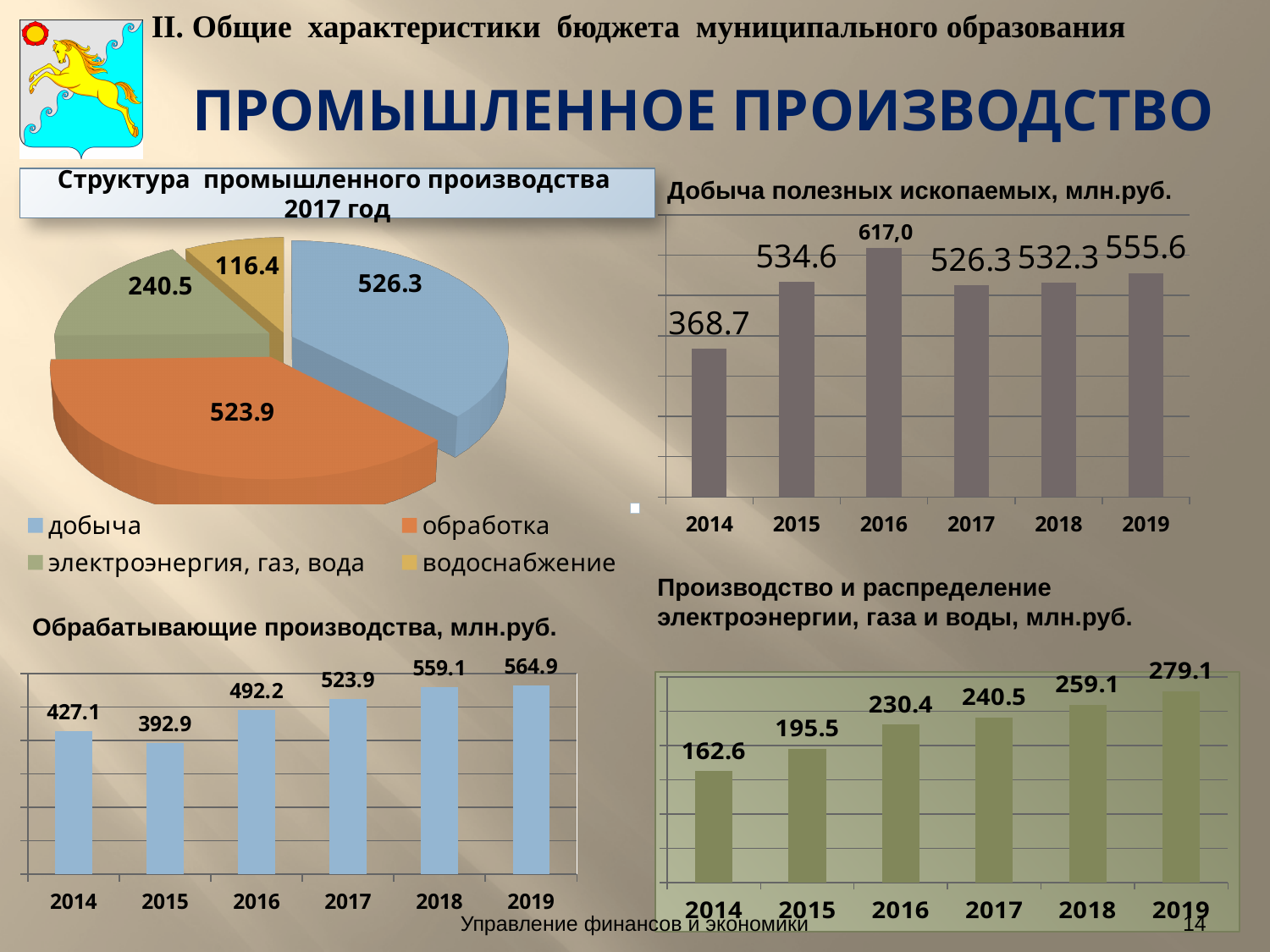
How many categories does the legend of the pie chart 'Структура промышленного производства 2017 год' list? 4 In the chart 'Добыча полезных ископаемых, млн.руб.', what is the value for 2016? 617,0 How many years are shown on the x axis of the chart 'Добыча полезных ископаемых, млн.руб.'? 6 In the chart 'Обрабатывающие производства, млн.руб.', what is the value for 2019? 564.9 In the chart 'Обрабатывающие производства, млн.руб.', which year has the lowest value? 2015 In the pie chart 'Структура промышленного производства 2017 год', what is the value for 'водоснабжение'? 116.4 In the chart 'Обрабатывающие производства, млн.руб.', what is the difference between the values for 2019 and 2014? 137.8 In the chart 'Добыча полезных ископаемых, млн.руб.', which year has the lowest value? 2014 In the chart 'Производство и распределение электроэнергии, газа и воды, млн.руб.', which year has the highest value? 2019 In the pie chart 'Структура промышленного производства 2017 год', which category has the smallest slice? водоснабжение In the chart 'Производство и распределение электроэнергии, газа и воды, млн.руб.', do the values rise or fall from 2014 to 2019? rise In the chart 'Производство и распределение электроэнергии, газа и воды, млн.руб.', what is the value for 2014? 162.6